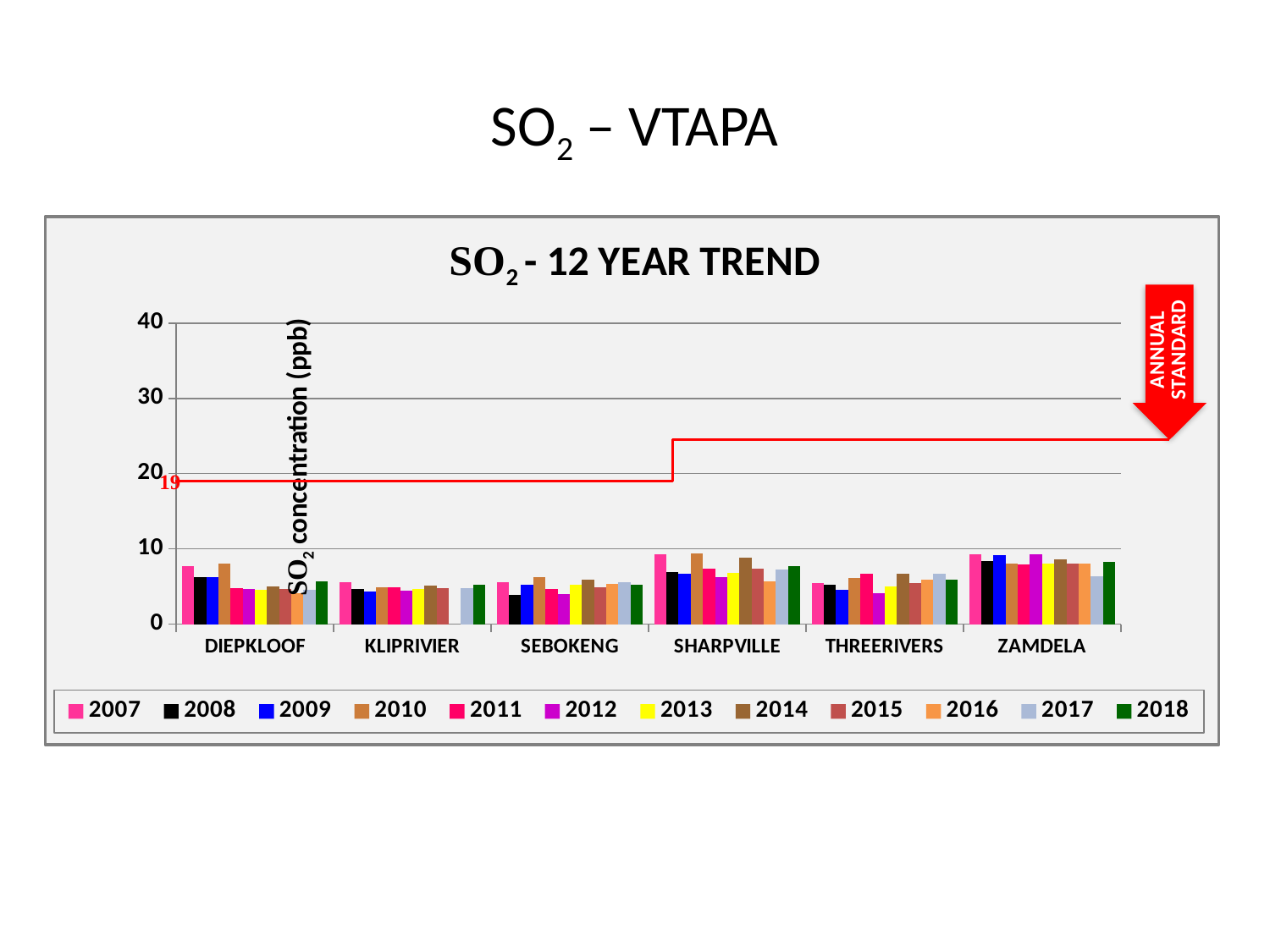
Which is larger, the 2008 value for ZAMDELA or the 2008 value for KLIPRIVIER? ZAMDELA What is the title of the chart on the slide? SO2 - 12 YEAR TREND Is the 2007 value for SHARPVILLE greater or less than 5? greater Are any of the plotted station values greater or less than 20 on the vertical axis? less Is the 2009 value for KLIPRIVIER greater or less than 10? less Which is larger, the 2008 value for SHARPVILLE or the 2008 value for SEBOKENG? SHARPVILLE What kind of chart is shown on the slide? bar chart What is the label of the vertical axis of the chart? SO2 concentration (ppb) How many series (years) does the legend of the SO2 - 12 YEAR TREND chart list? 12 How many monitoring stations are shown along the x axis of the SO2 - 12 YEAR TREND chart? 6